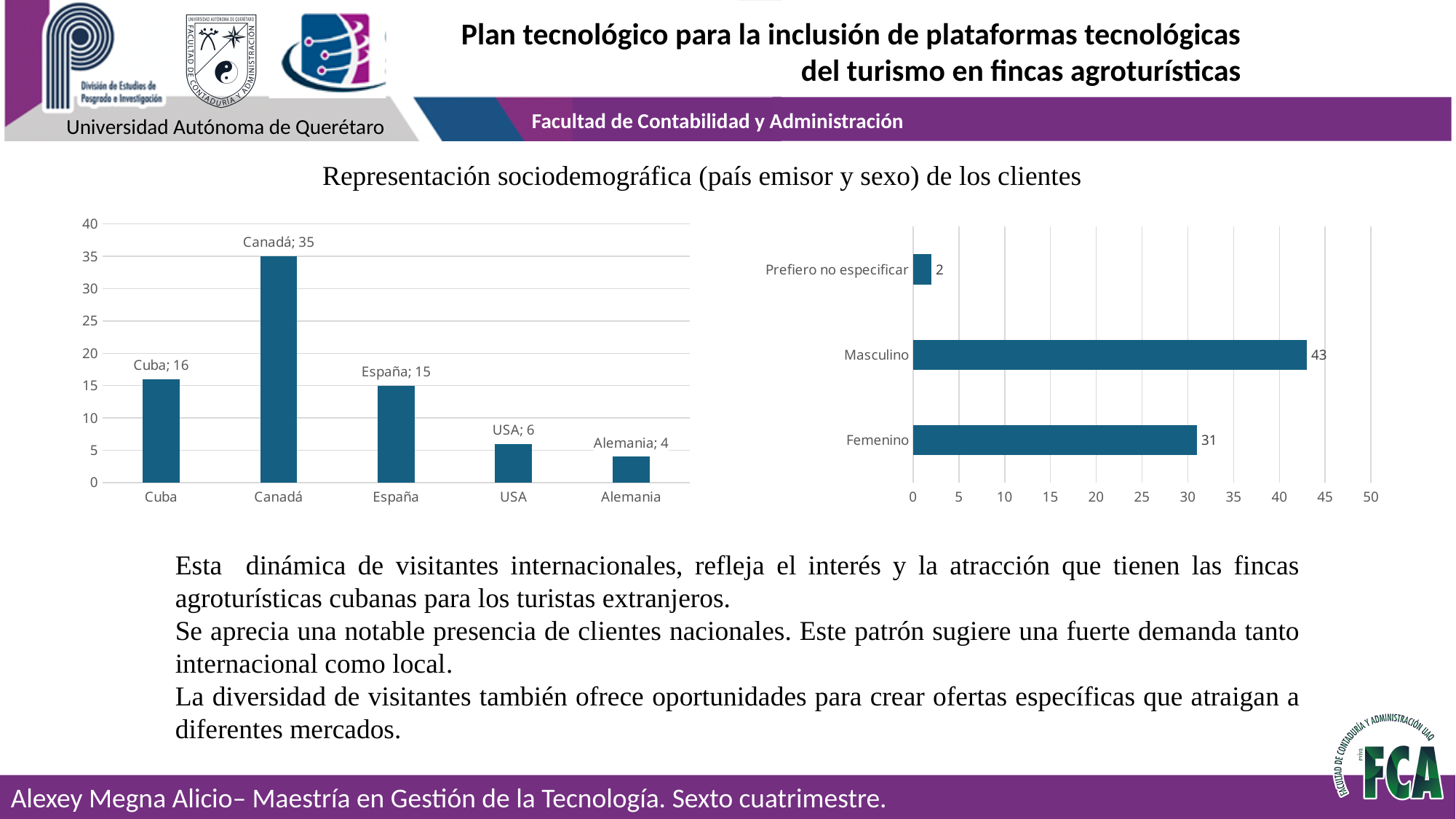
In the right chart (sex), what is the value for Prefiero no especificar? 2 In the right chart (sex), what is the value for Masculino? 43 In the right chart (sex), what is the difference between the values for Masculino and Femenino? 12 In the left chart (country of origin), which country has the highest value? Canadá In the left chart (country of origin), which is larger, the value for Cuba or the value for España? Cuba In the left chart (country of origin), what is the value for Canadá? 35 In the right chart (sex), what is the total of all three categories? 76 In the left chart (country of origin), which country has the lowest value? Alemania In the left chart (country of origin), how many countries are shown? 5 In the left chart (country of origin), what is the value for Cuba? 16 In the left chart (country of origin), what is the difference between the values for Canadá and España? 20 What kind of chart is the right chart (sex)? Bar chart